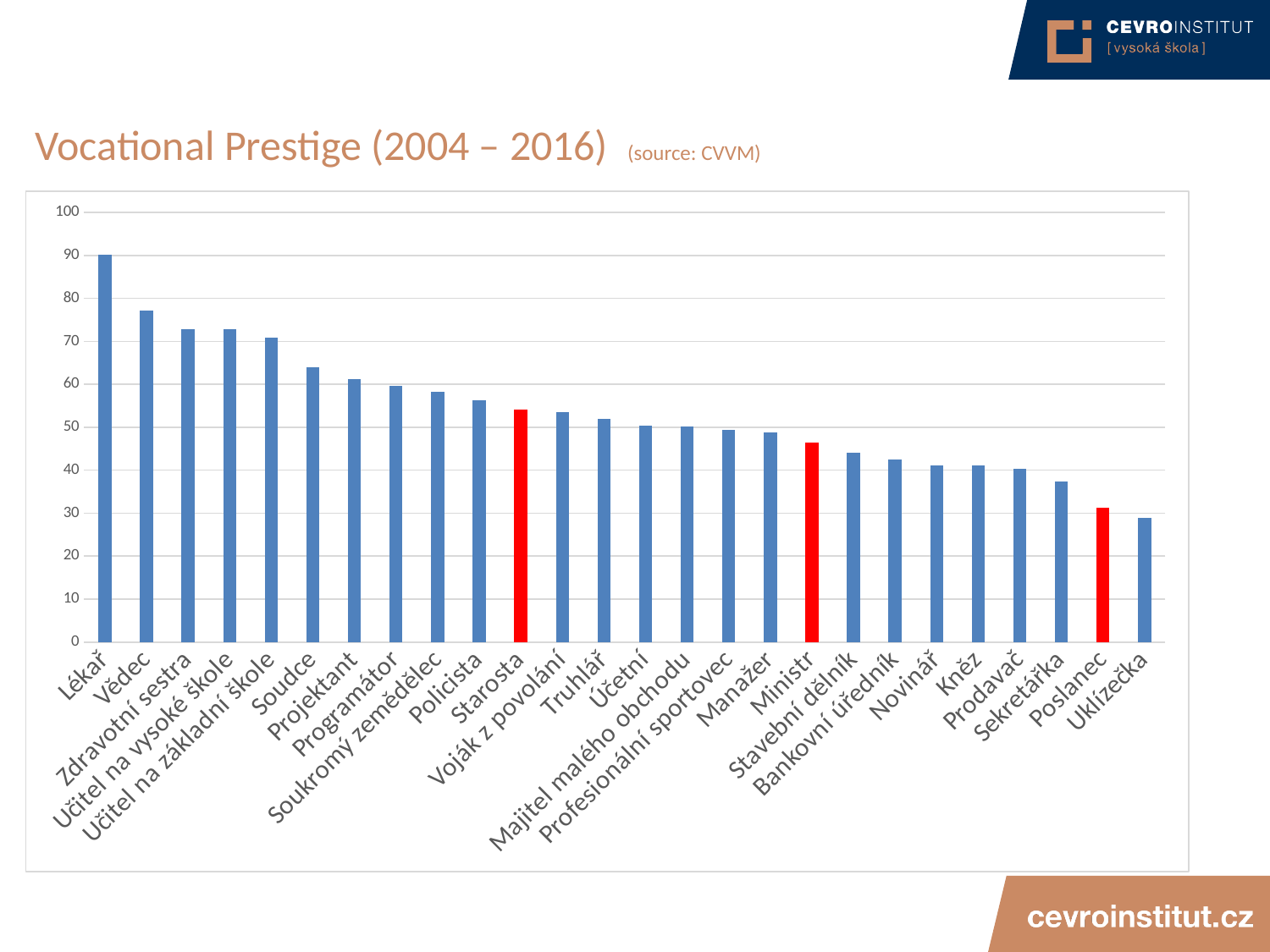
Do the values rise or fall moving from left to right along the x axis? fall Which occupation has the lowest prestige value in the chart? Uklízečka Is the value for Lékař greater or less than 80? greater Which has a larger value, Ministr or Poslanec? Ministr Which has a larger value, Soudce or Policista? Soudce Which occupation has the highest prestige value in the chart? Lékař Is the value for Vědec greater or less than 70? greater Which three occupations are shown with red bars? Starosta, Ministr, Poslanec Is the value for Sekretářka greater or less than 40? less What kind of chart is shown on the slide? bar chart How many occupations are plotted in the chart? 26